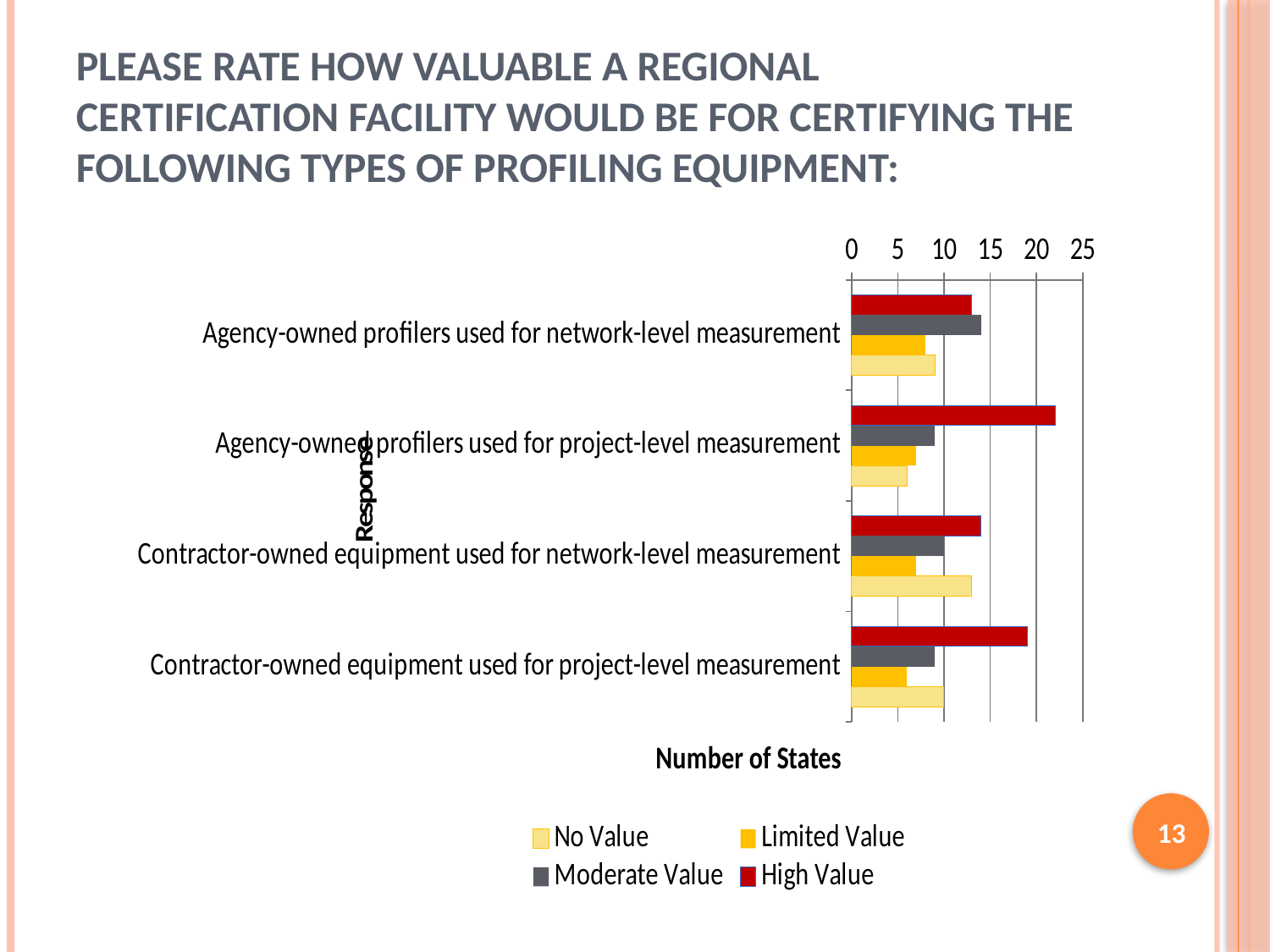
Is the Limited Value bar for Agency-owned profilers used for network-level measurement greater or less than 10? less Is the High Value bar for Contractor-owned equipment used for project-level measurement greater or less than 15? greater For Contractor-owned equipment used for project-level measurement, which series has the shortest bar? Limited Value What kind of chart is shown on the slide? bar chart For Agency-owned profilers used for project-level measurement, which is larger: the High Value bar or the No Value bar? High Value Is the High Value bar for Agency-owned profilers used for project-level measurement greater or less than 20? greater Which category has the longest High Value bar? Agency-owned profilers used for project-level measurement How many series does the chart legend list? 4 What is the title of the horizontal axis? Number of States Which series is shown in dark red in the legend? High Value How many equipment categories are plotted on the chart? 4